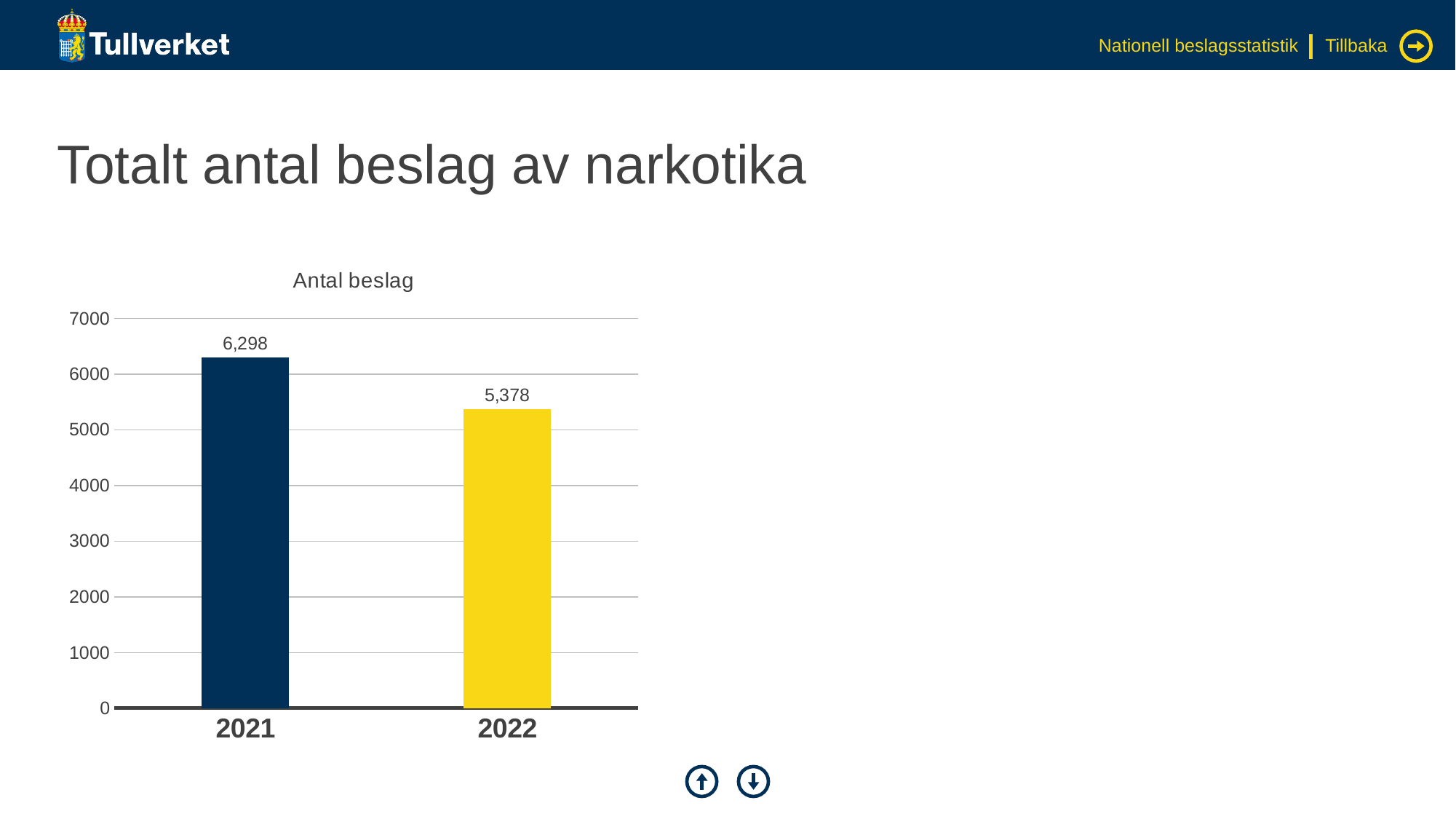
What is the difference between the values for 2021 and 2022? 920 Is the value for 2022 greater or less than 6000? less What is the title of the chart? Antal beslag Is the value for 2021 greater or less than 6000? greater Which year has the lowest number of seizures? 2022 What is the value for 2022? 5,378 Which year has the highest number of seizures? 2021 What kind of chart is shown on the slide? bar chart How many years are shown on the x axis? 2 Which is larger, the value for 2021 or the value for 2022? 2021 What is the value for 2021? 6,298 Do the values rise or fall from 2021 to 2022? fall